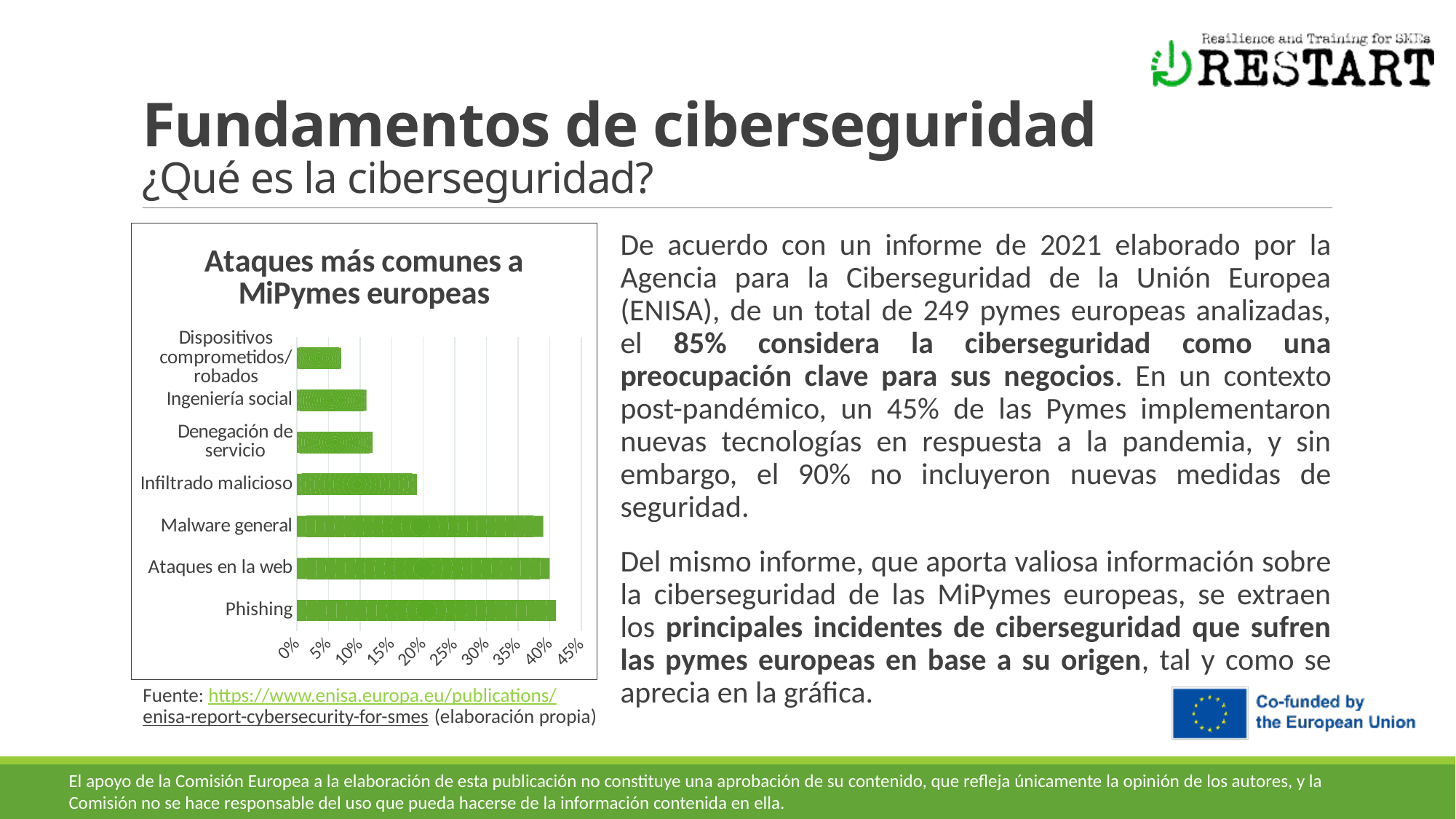
Which is larger, the value for Infiltrado malicioso or the value for Ingeniería social? Infiltrado malicioso Is the value for Phishing greater or less than 35%? greater Which is larger, the value for Malware general or the value for Infiltrado malicioso? Malware general What kind of chart is shown on the slide? bar chart Which attack category has the lowest value in the chart? Dispositivos comprometidos/robados How many attack categories are plotted in the chart? 7 Is the value for Malware general greater or less than 35%? greater Is the value for Denegación de servicio greater or less than 15%? less What colour are the bars in the chart? green What is the title of the chart? Ataques más comunes a MiPymes europeas